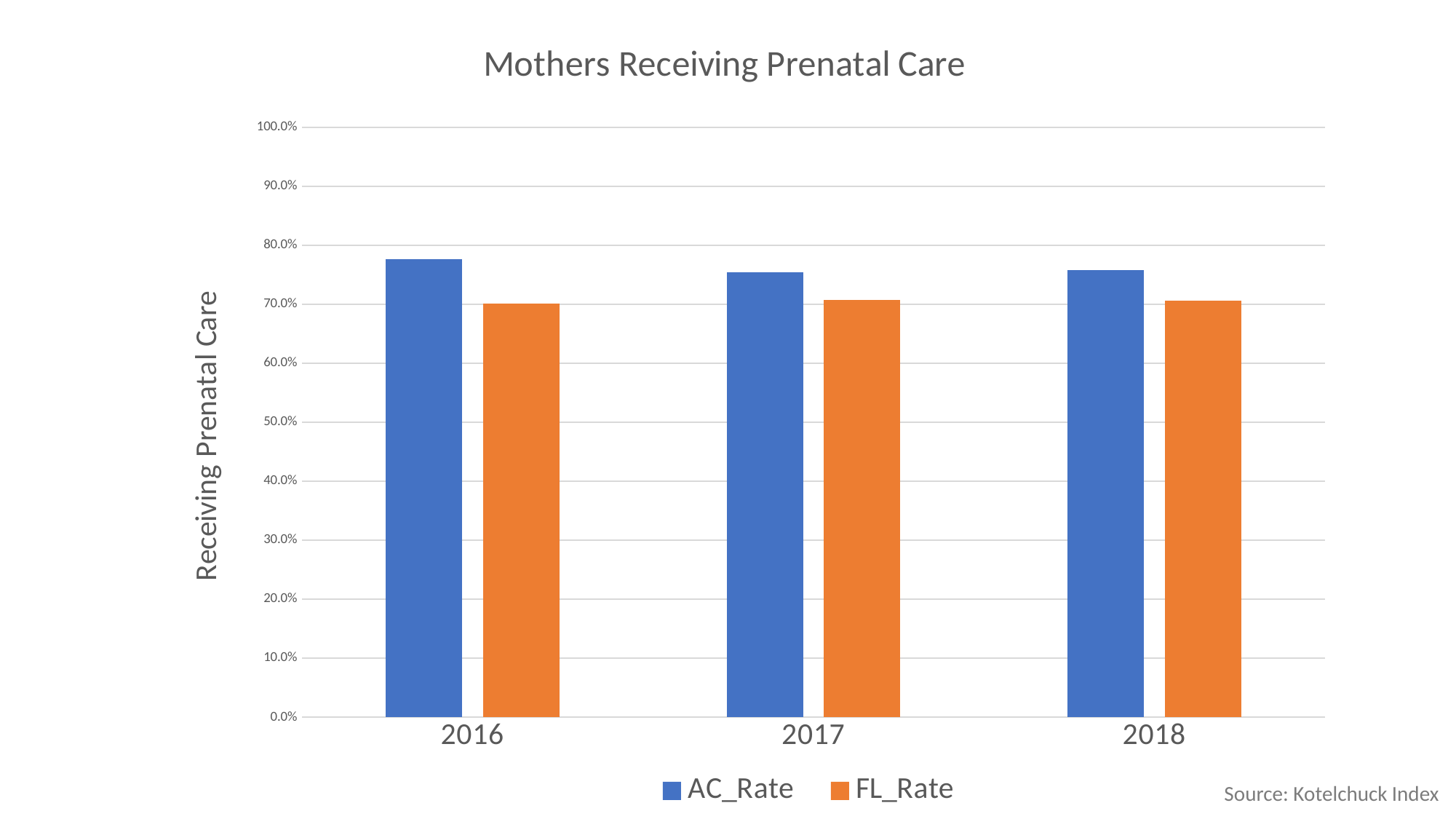
How many series does the legend list? 2 In 2016, which is larger, AC_Rate or FL_Rate? AC_Rate In which year is the AC_Rate highest? 2016 How many years are shown on the x axis? 3 What kind of chart is shown on the slide? bar chart Does the AC_Rate rise or fall from 2016 to 2017? fall What is the source cited for the chart? Kotelchuck Index Is the FL_Rate value for 2018 greater or less than 60.0%? greater What is the title of the chart? Mothers Receiving Prenatal Care In 2018, which is larger, AC_Rate or FL_Rate? AC_Rate Is the AC_Rate value for 2016 greater or less than 80.0%? less Is the AC_Rate value for 2017 greater or less than 70.0%? greater